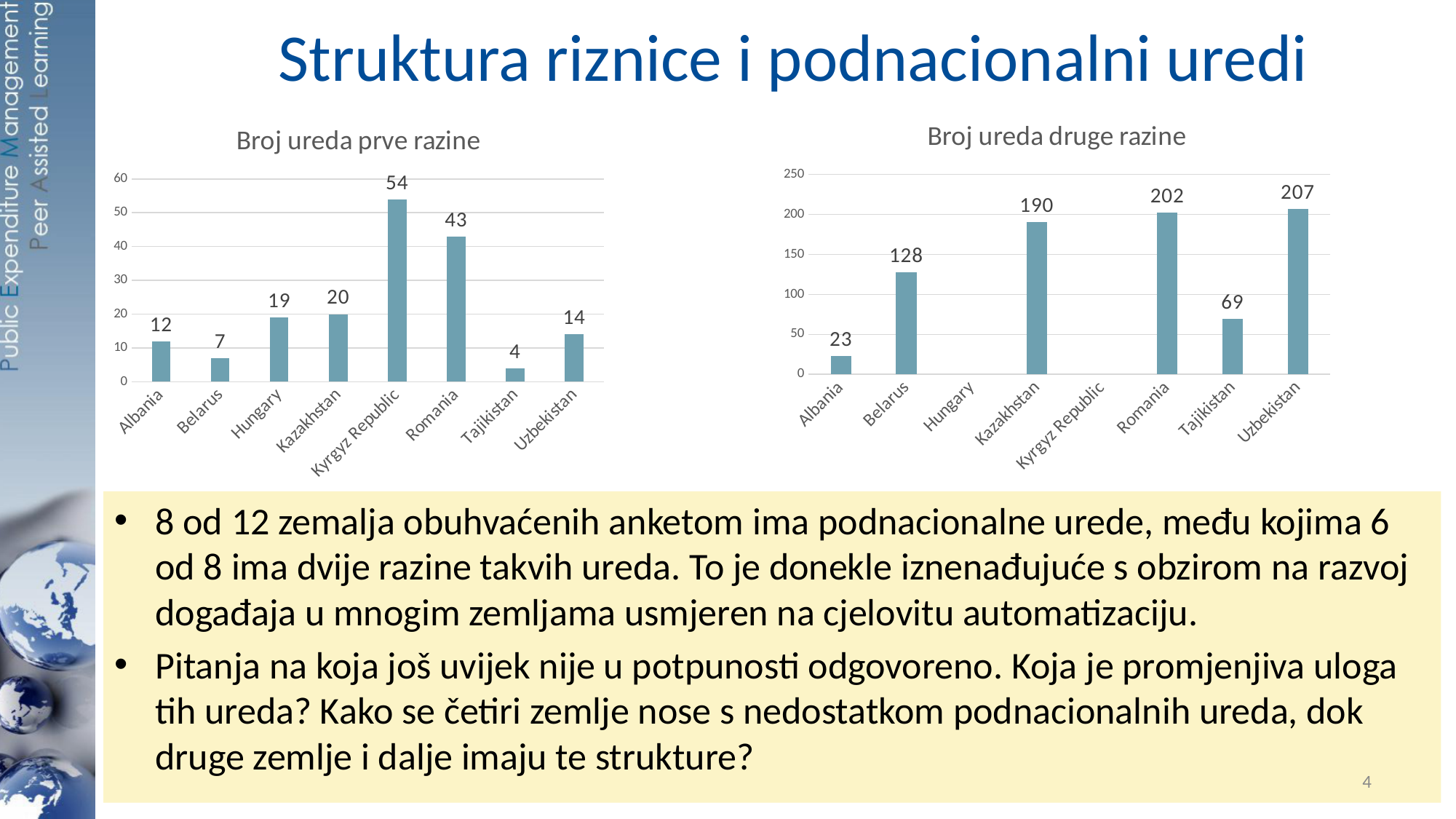
In the chart titled 'Broj ureda druge razine', which country has the highest value? Uzbekistan In the chart titled 'Broj ureda prve razine', how many countries are shown on the x axis? 8 In the chart titled 'Broj ureda prve razine', what is the difference between Kyrgyz Republic and Romania? 11 In the chart titled 'Broj ureda druge razine', what is the value for Tajikistan? 69 In the chart titled 'Broj ureda druge razine', what is the difference between Romania and Kazakhstan? 12 In the chart titled 'Broj ureda druge razine', which is larger, the value for Albania or the value for Tajikistan? Tajikistan In the chart titled 'Broj ureda prve razine', which country has the lowest value? Tajikistan What is the title of the chart on the right side of the slide? Broj ureda druge razine In the chart titled 'Broj ureda prve razine', which is larger, the value for Hungary or the value for Uzbekistan? Hungary In the chart titled 'Broj ureda druge razine', what is the value for Belarus? 128 In the chart titled 'Broj ureda prve razine', what is the value for Kyrgyz Republic? 54 What type of chart is the chart titled 'Broj ureda prve razine'? Bar chart